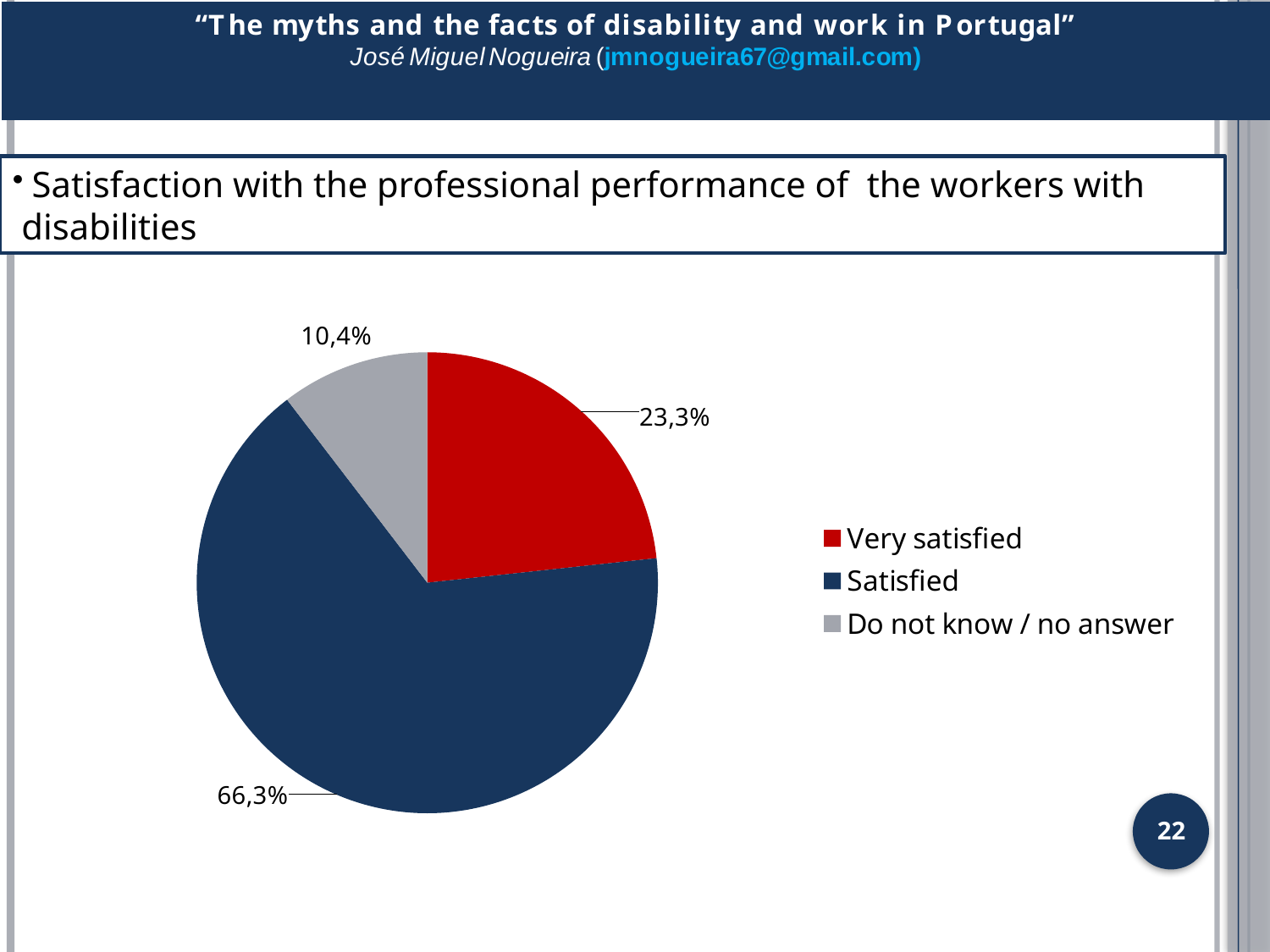
How many slices does the pie chart have? 3 What percentage of the pie is labelled 'Very satisfied'? 23,3% What colour is the 'Very satisfied' slice? red What is the difference in percentage points between the 'Satisfied' and 'Very satisfied' slices? 43,0 Which category has the largest slice of the pie? Satisfied What percentage of the pie is labelled 'Satisfied'? 66,3% Which slice is larger, 'Very satisfied' or 'Do not know / no answer'? Very satisfied What percentage of the pie is labelled 'Do not know / no answer'? 10,4% What colour is the 'Do not know / no answer' slice? grey Which category has the smallest slice of the pie? Do not know / no answer What kind of chart is shown on the slide? pie chart How many entries does the legend list? 3